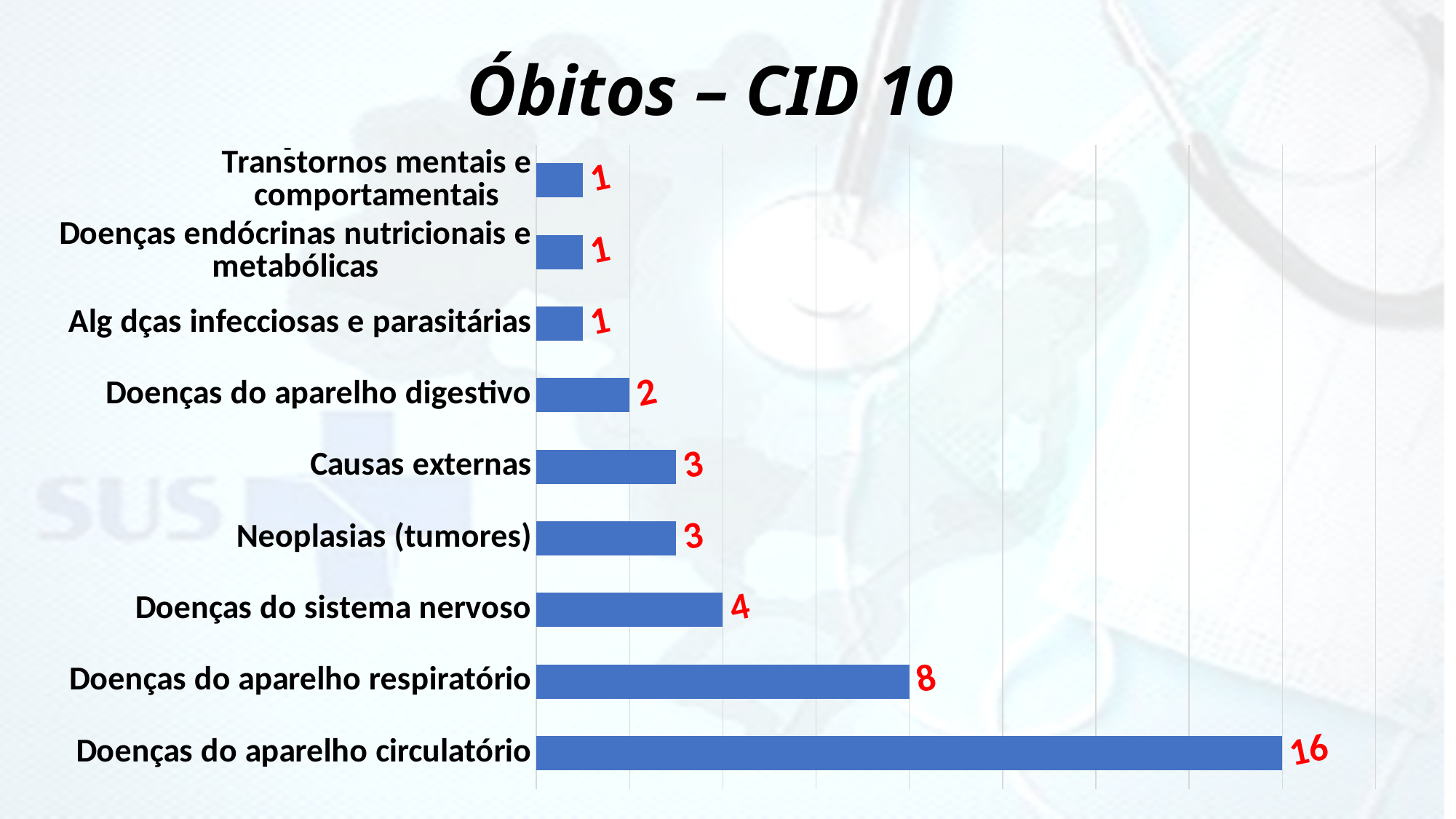
What is the difference between Doenças do sistema nervoso and Doenças do aparelho digestivo? 2 What is the value for Doenças do sistema nervoso? 4 What is the value for Doenças do aparelho circulatório? 16 Which is larger, Causas externas or Doenças do sistema nervoso? Doenças do sistema nervoso What kind of chart is shown on the slide? Bar chart What is the value for Doenças do aparelho respiratório? 8 What is the value for Doenças do aparelho digestivo? 2 What is the title of the chart? Óbitos – CID 10 Which category has the highest value? Doenças do aparelho circulatório What is the value for Neoplasias (tumores)? 3 How many categories are shown in the chart? 9 What is the difference between Doenças do aparelho circulatório and Doenças do aparelho respiratório? 8